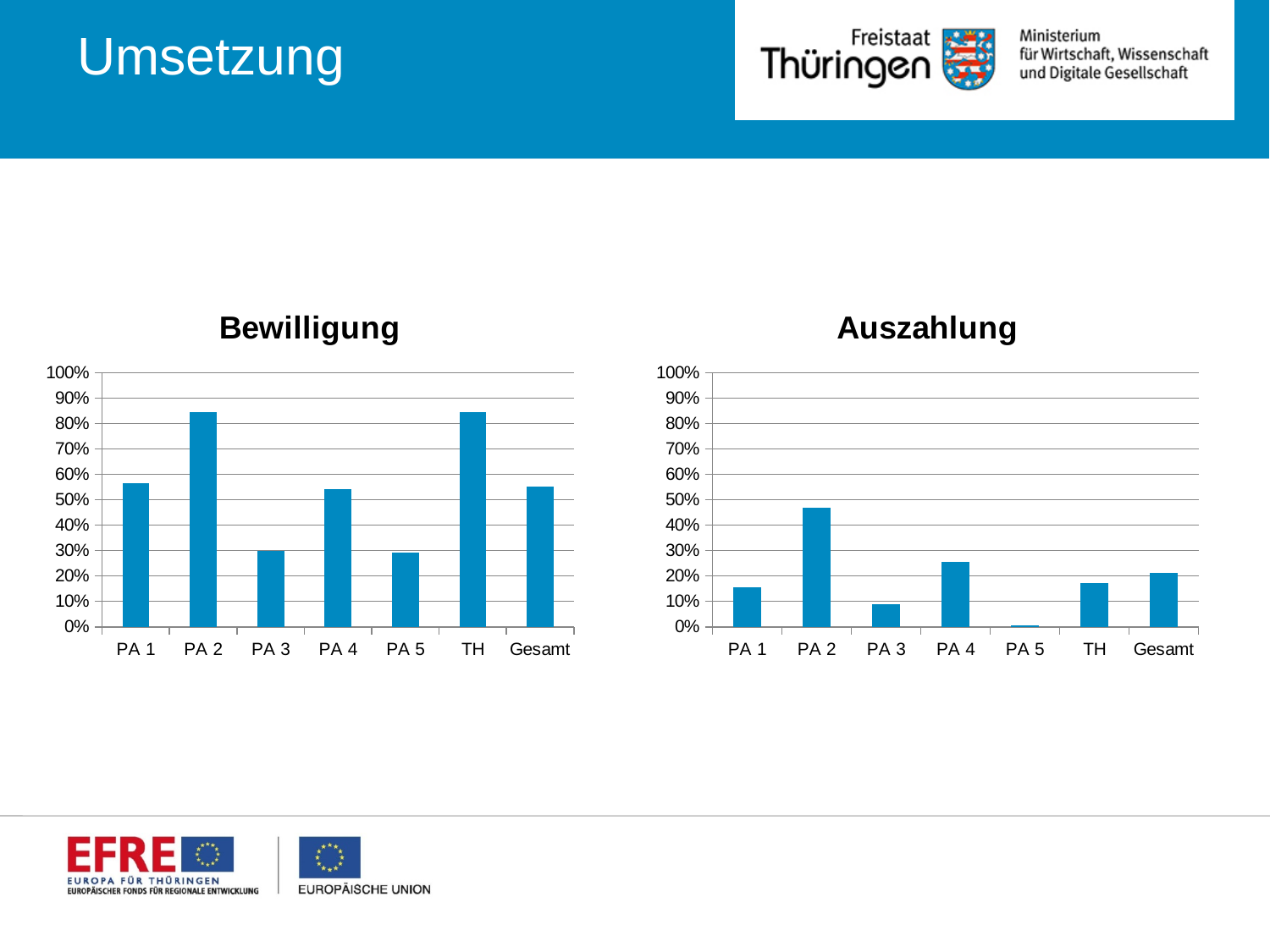
How many categories are shown on the x axis of the Auszahlung chart? 7 In the Auszahlung chart, which category has the highest value? PA 2 In the Auszahlung chart, is the value for Gesamt greater or less than 30%? less In the Auszahlung chart, which is larger, the value for PA 1 or the value for PA 4? PA 4 In the Bewilligung chart, which is larger, the value for PA 2 or the value for PA 3? PA 2 In the Bewilligung chart, is the value for PA 1 greater or less than 50%? greater In the Auszahlung chart, which category has the lowest value? PA 5 In the Auszahlung chart, is the value for PA 2 greater or less than 40%? greater What is the title of the chart on the right side of the slide? Auszahlung What kind of chart is the Bewilligung chart? bar chart What is the highest value shown on the y axis of the Bewilligung chart? 100%